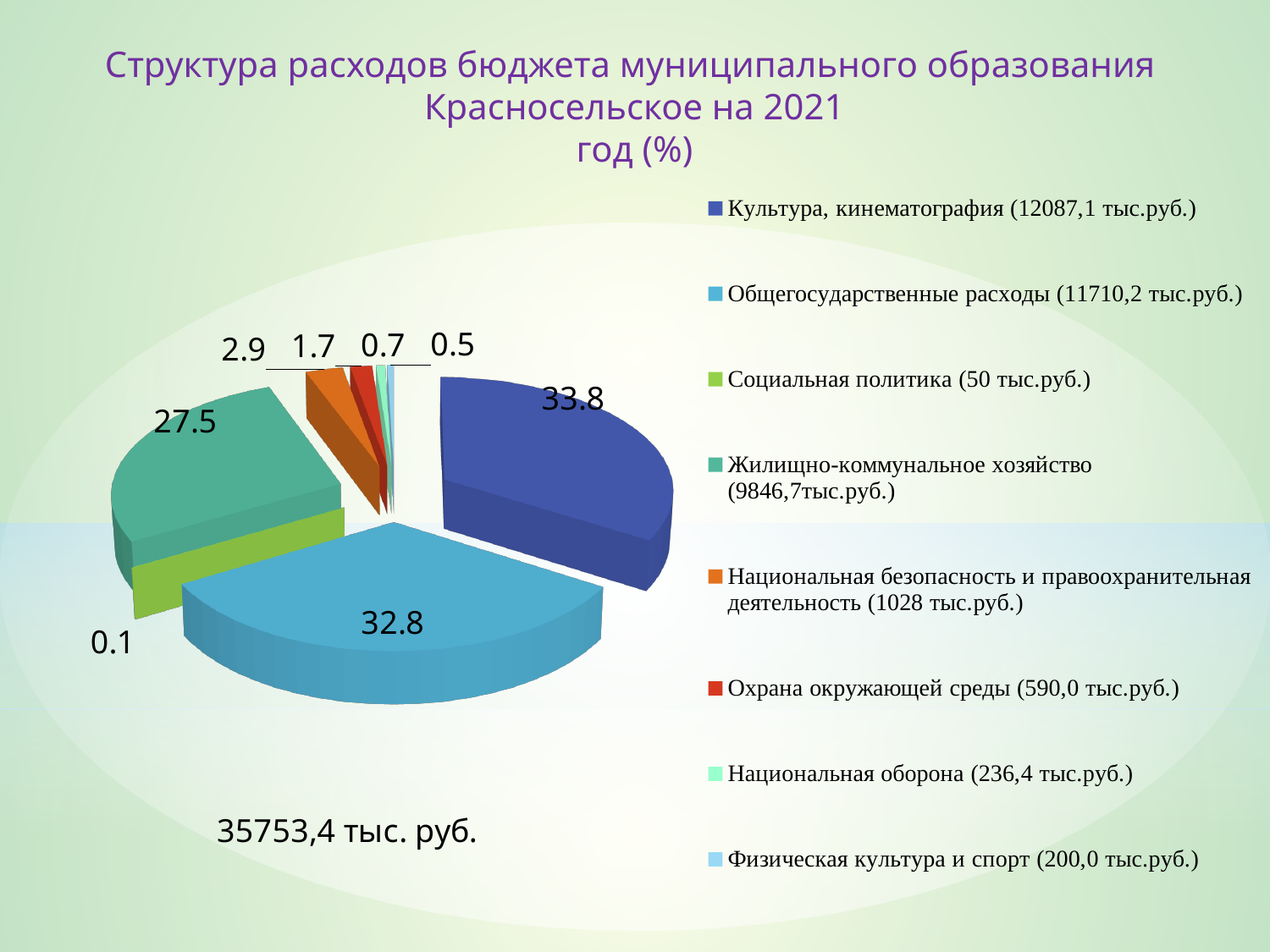
Which has a larger share: Охрана окружающей среды or Национальная оборона? Охрана окружающей среды What is the difference in percentage points between the shares of Культура, кинематография and Общегосударственные расходы? 1.0 Which category has the smallest share of the pie? Социальная политика What amount in тыс.руб. is given in the legend for Жилищно-коммунальное хозяйство? 9846,7 тыс.руб. What percentage share is shown for Жилищно-коммунальное хозяйство? 27.5 Which category has the largest share of the pie? Культура, кинематография What total amount is printed below the pie chart? 35753,4 тыс. руб. How many categories does the legend of the pie chart list? 8 What percentage share is shown for Национальная безопасность и правоохранительная деятельность? 2.9 What percentage share is shown for Общегосударственные расходы? 32.8 What percentage share is shown for Культура, кинематография? 33.8 What type of chart is shown on the slide? Pie chart